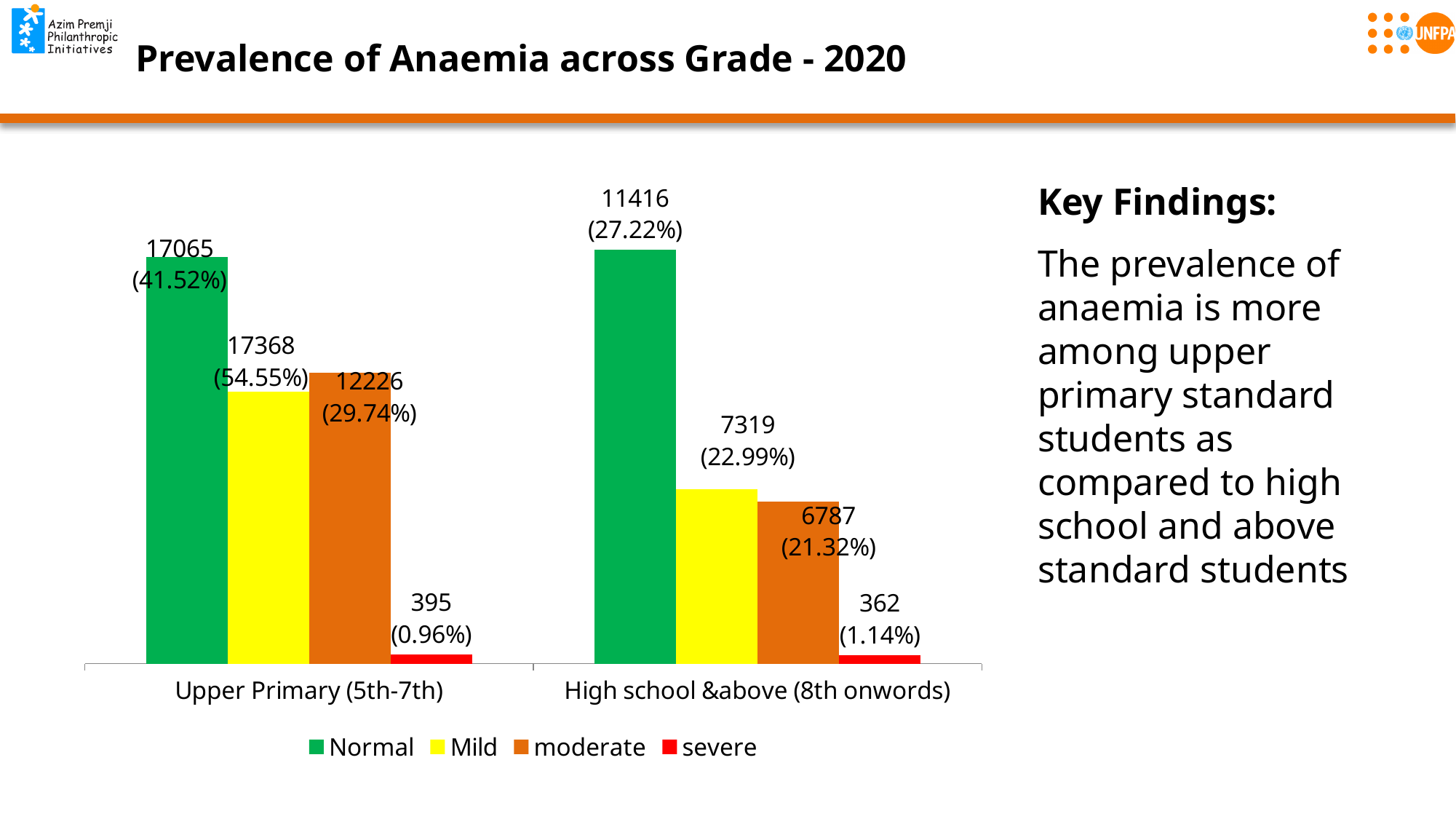
Which is larger, the severe count for Upper Primary (5th-7th) or for High school &above (8th onwords)? Upper Primary (5th-7th) What is the value for severe in the Upper Primary (5th-7th) category? 395 (0.96%) Which colour represents the Mild series in the legend? yellow How many series does the legend list? 4 What type of chart is shown on the slide? bar chart What is the value for Normal in the Upper Primary (5th-7th) category? 17065 (41.52%) What is the value for Mild in the High school &above (8th onwords) category? 7319 (22.99%) How many grade categories are shown on the x axis? 2 Which series has the lowest value in the High school &above (8th onwords) category? severe What is the title of the chart? Prevalence of Anaemia across Grade - 2020 What is the difference between the moderate counts for Upper Primary (5th-7th) and High school &above (8th onwords)? 5439 What percentage is shown for moderate in the High school &above (8th onwords) category? 21.32%